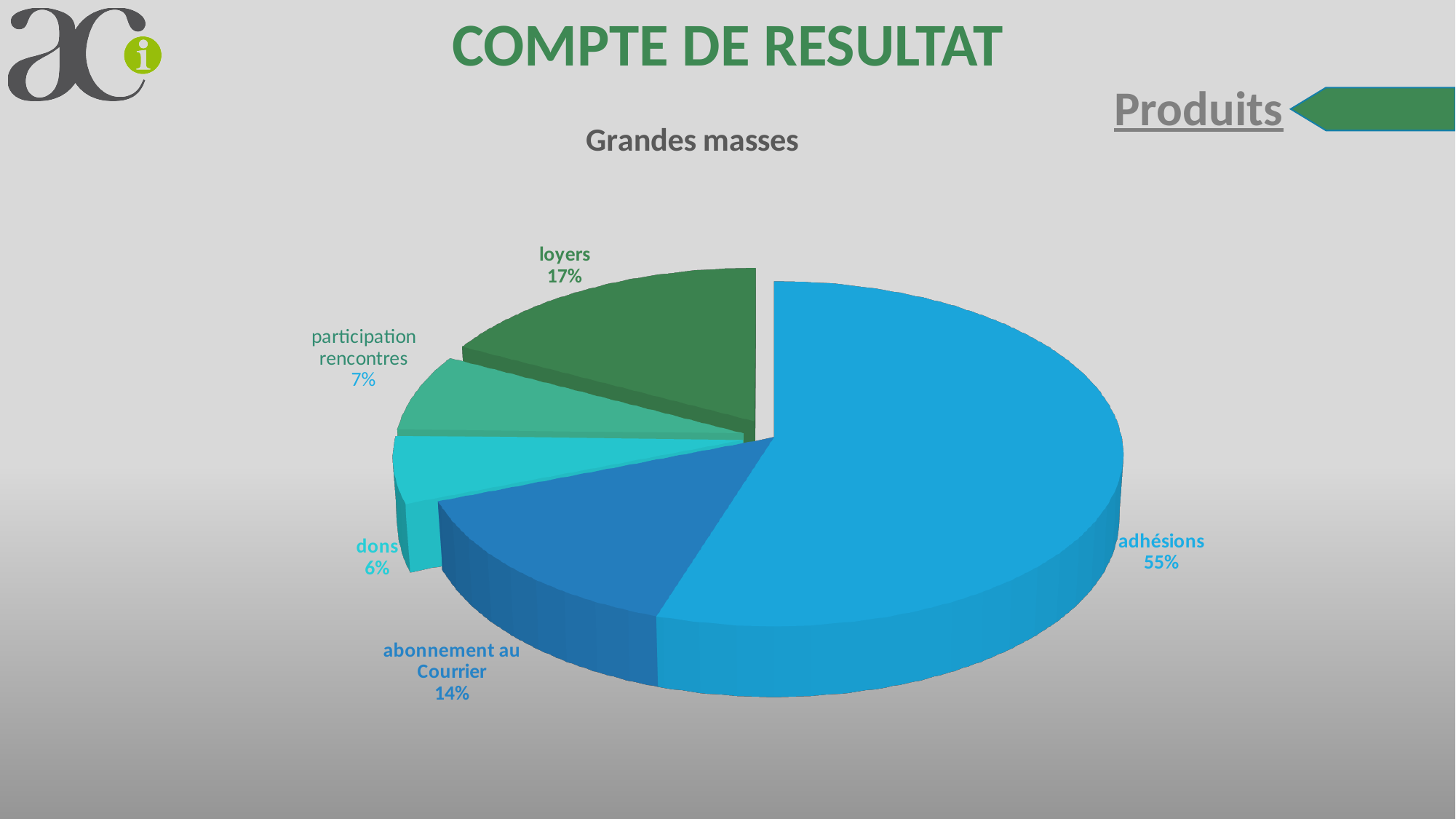
Which category has the smallest slice of the pie? dons What type of chart is shown on the slide? pie chart What is the difference in percentage points between loyers and abonnement au Courrier? 3 How many slices does the pie chart have? 5 What share of the pie does abonnement au Courrier represent? 14% What share of the pie does dons represent? 6% Which category has the largest slice of the pie? adhésions What share of the pie does loyers represent? 17% What is the difference in percentage points between adhésions and loyers? 38 Which is larger, the share for loyers or the share for abonnement au Courrier? loyers